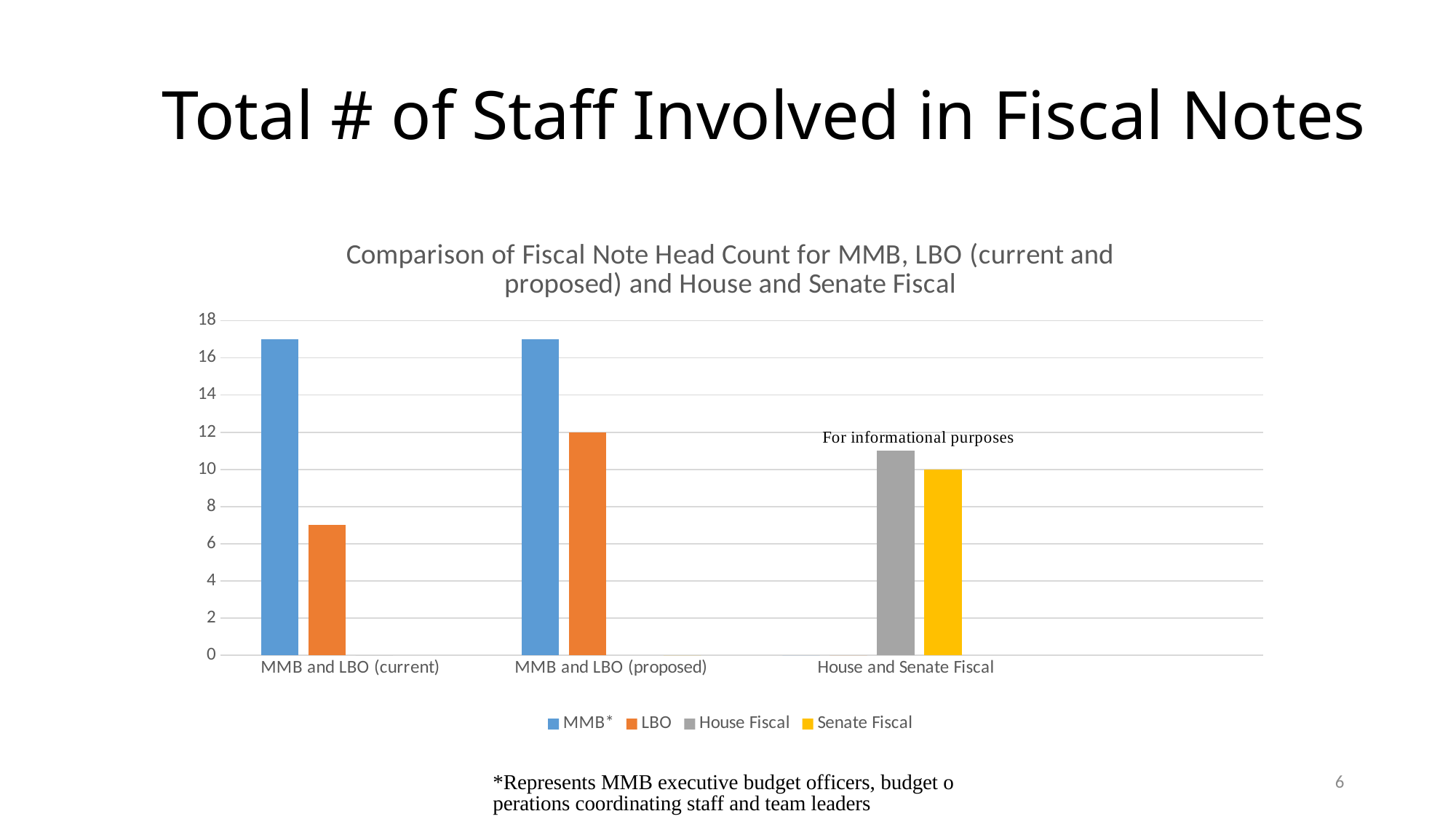
Which is larger, the LBO value for MMB and LBO (current) or the LBO value for MMB and LBO (proposed)? MMB and LBO (proposed) What is the Senate Fiscal value for House and Senate Fiscal? 10 What kind of chart is shown on the slide? bar chart Which series has the tallest bar in the MMB and LBO (proposed) category? MMB* Which series has the lowest bar in the House and Senate Fiscal category? Senate Fiscal What is the LBO value for MMB and LBO (proposed)? 12 How many categories are shown on the x axis? 3 Is the House Fiscal value for House and Senate Fiscal greater or less than 10? greater Is the MMB* value for MMB and LBO (current) greater or less than 16? greater How many series does the legend list? 4 What colour are the House Fiscal bars? gray Is the LBO value for MMB and LBO (current) greater or less than 8? less